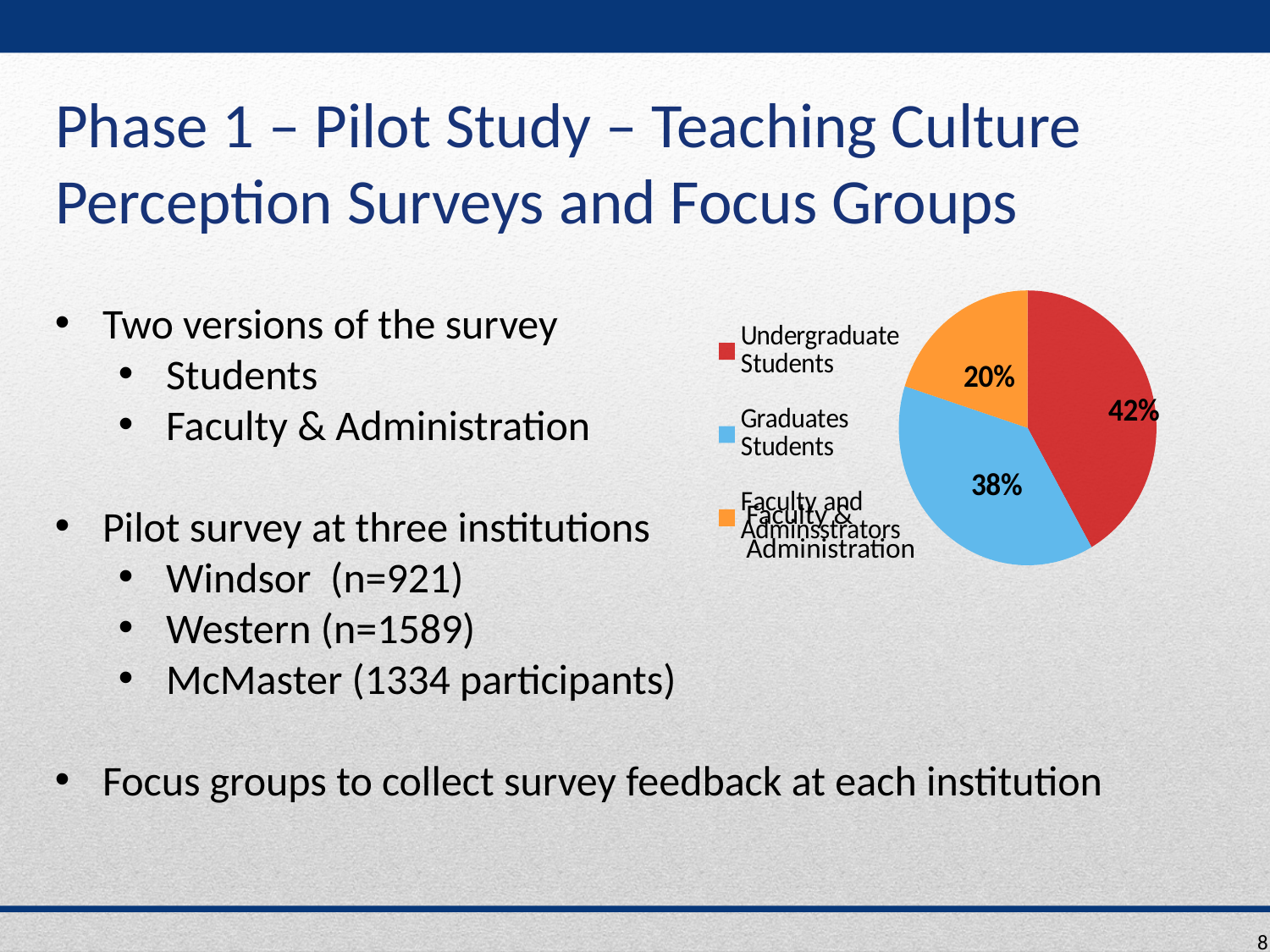
What colour is the Undergraduate Students slice in the pie chart? Red What is the difference in percentage points between the Graduates Students slice and the Faculty & Administration slice? 18 What percentage of the pie chart is the orange Faculty & Administration slice? 20% What colour is the Graduates Students slice in the pie chart? Blue What kind of chart is shown on the slide? Pie chart Which is larger in the pie chart, Undergraduate Students or Faculty & Administration? Undergraduate Students What percentage of the pie chart is Graduates Students? 38% What percentage of the pie chart is Undergraduate Students? 42% What is the difference in percentage points between the Undergraduate Students slice and the Graduates Students slice? 4 Which slice of the pie chart is the largest? Undergraduate Students How many slices does the pie chart have? 3 Which slice of the pie chart is the smallest? Faculty & Administration